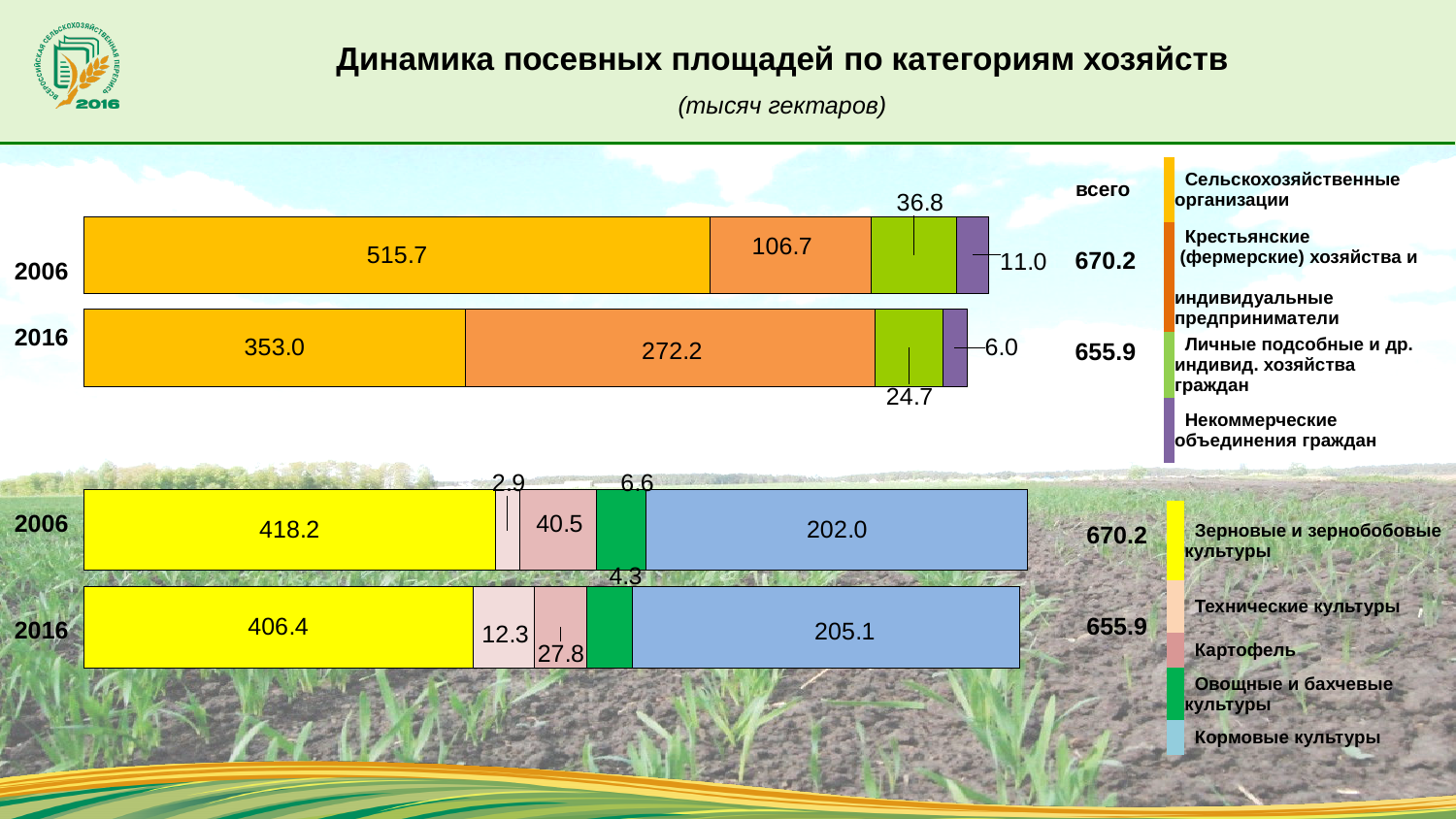
In the top chart, which category has the smallest value in 2016? Некоммерческие объединения граждан In the bottom chart, what is the difference between the technical crops values for 2016 and 2006? 9.4 In the top chart, by how much did the value for agricultural organizations fall from 2006 to 2016? 162.7 What type of chart is used on this slide? Stacked bar chart How many series does the legend of the top chart list? 4 In the top chart, what is the value for agricultural organizations (Сельскохозяйственные организации) in 2006? 515.7 In the top chart, what is the total (всего) for 2016? 655.9 In the top chart, what is the value for peasant (farmer) holdings and individual entrepreneurs in 2016? 272.2 In the bottom chart, what is the value for potatoes (Картофель) in 2006? 40.5 In the bottom chart, is the value for fodder crops (Кормовые культуры) larger in 2006 or in 2016? 2016 In the bottom chart, what is the value for grain and leguminous crops (Зерновые и зернобобовые культуры) in 2016? 406.4 How many series does the legend of the bottom chart list? 5